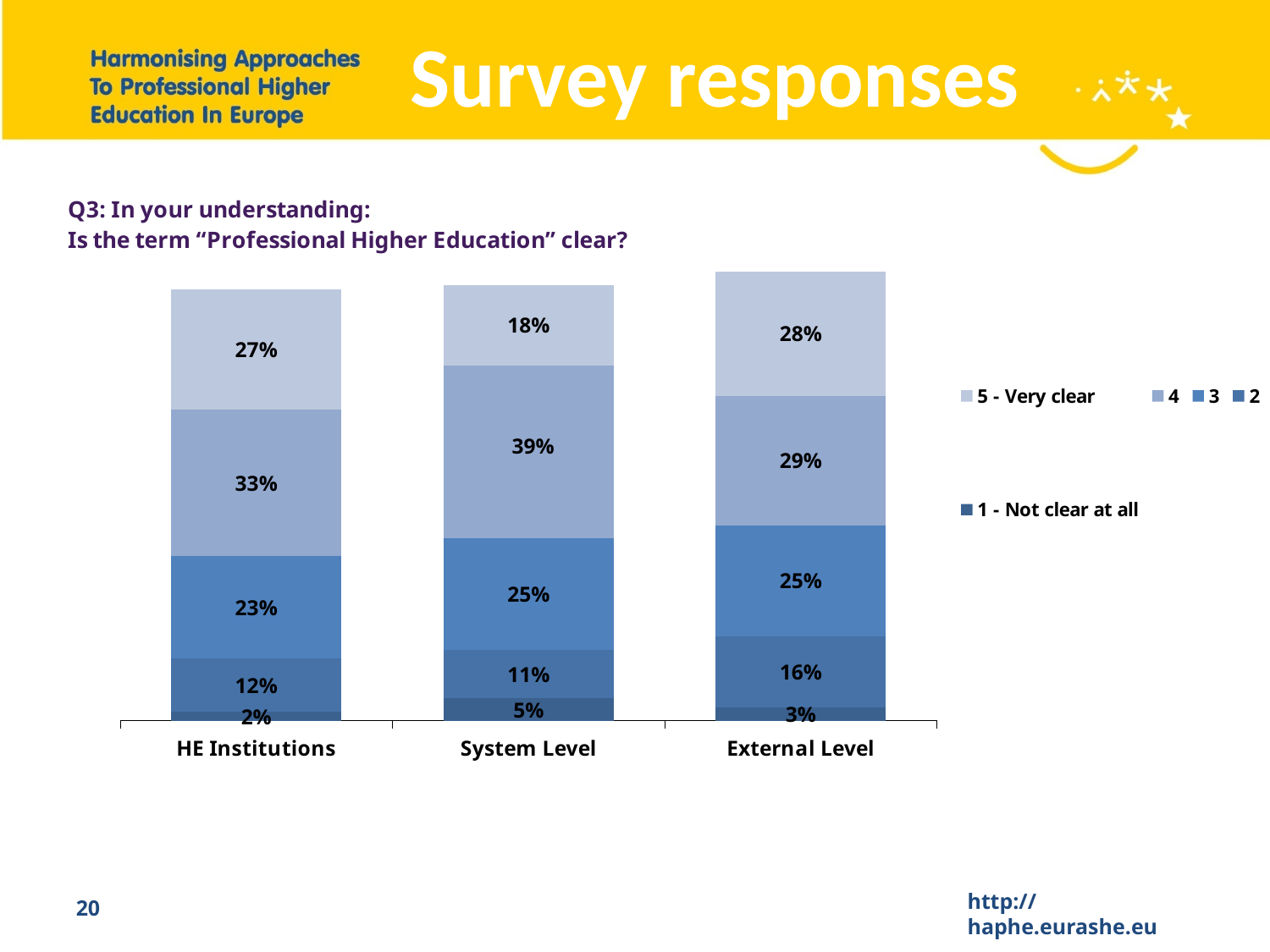
Which category has the highest value for '5 - Very clear'? External Level What is the value for '1 - Not clear at all' for External Level? 3% How many series does the chart's legend list? 5 Which is larger: the '2' value for External Level or the '2' value for HE Institutions? External Level How many categories are shown on the x axis of the chart? 3 Which category has the lowest value for '1 - Not clear at all'? HE Institutions What is the value for '2' for System Level? 11% What is the value for '4' for System Level? 39% What kind of chart is shown on the slide? stacked bar chart What is the value for '5 - Very clear' for HE Institutions? 27% What is the difference between the '4' values for System Level and HE Institutions? 6% What is the first entry listed in the chart's legend? 5 - Very clear